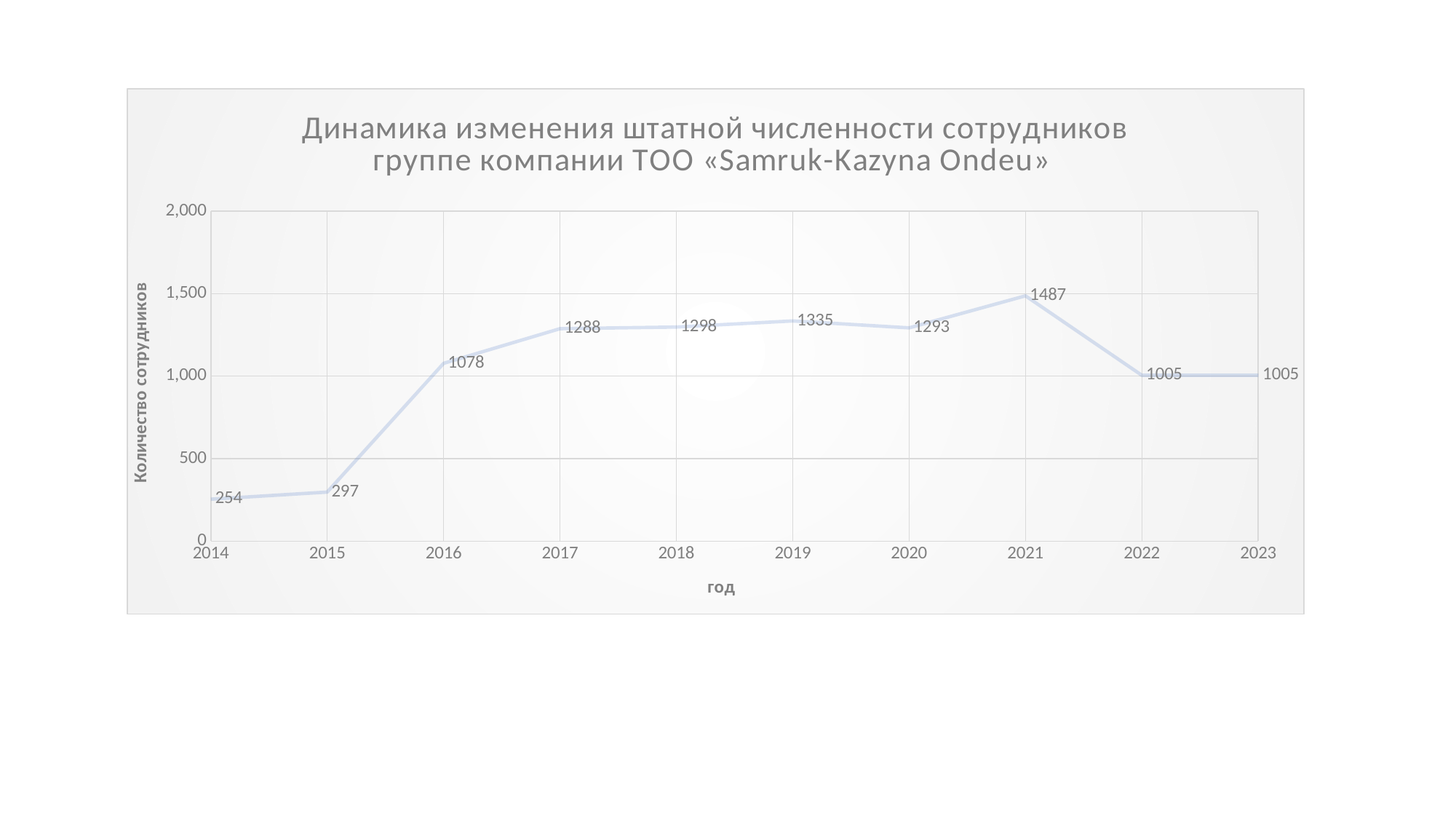
Is the value for 2017 greater or less than 1,000? greater What is the number of employees in 2016? 1078 What is the number of employees in 2021? 1487 What is the number of employees in 2014? 254 Does the number of employees rise or fall from 2014 to 2016? rise What is the difference between the number of employees in 2021 and in 2022? 482 Which year has more employees, 2019 or 2020? 2019 What kind of chart is shown on the slide? line chart How many years are plotted on the chart? 10 What is the difference between the number of employees in 2016 and in 2015? 781 Which year has the highest number of employees? 2021 Which year has the lowest number of employees? 2014